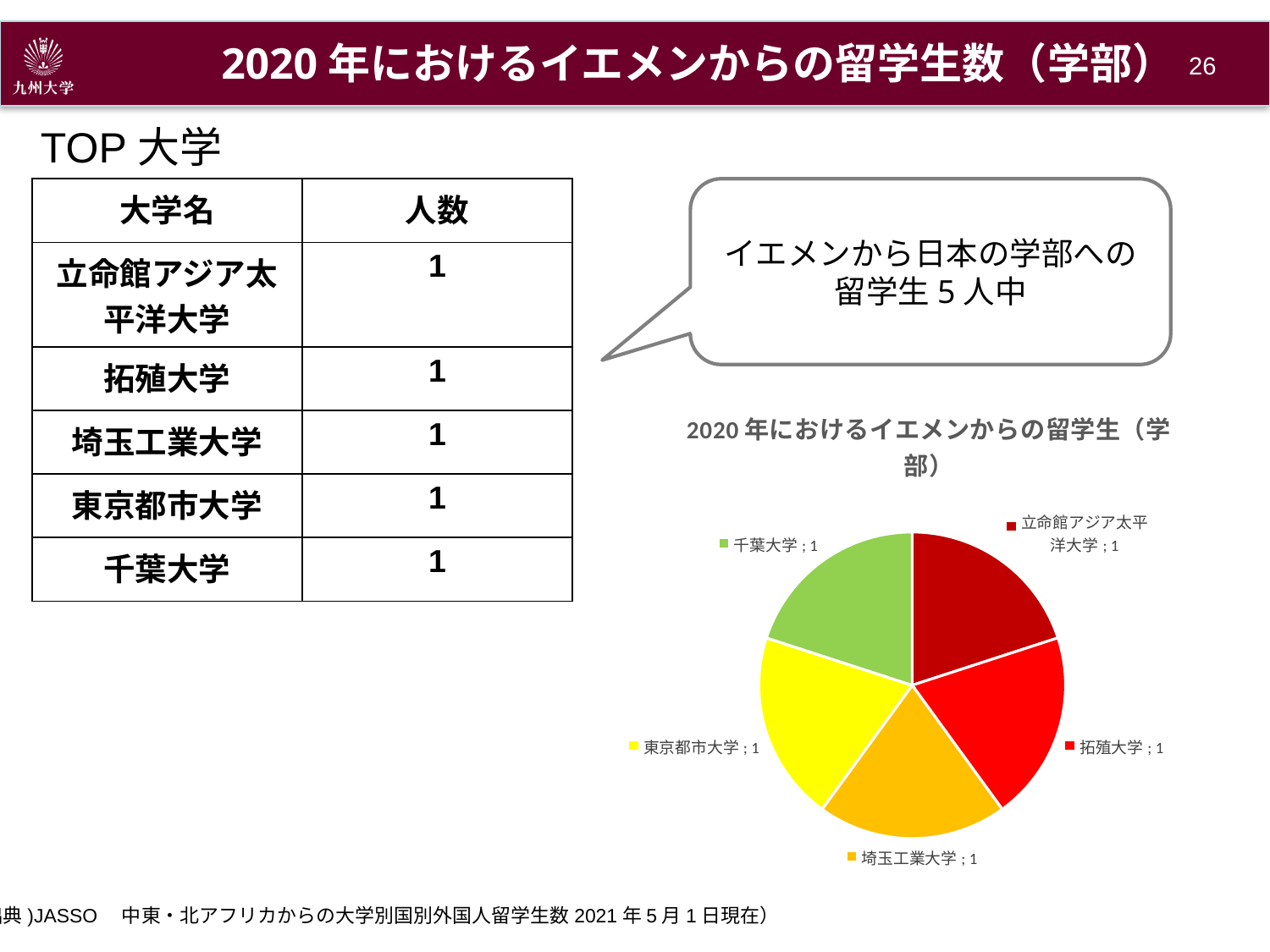
What is the value shown for 千葉大学 in the pie chart? 1 Which slice of the pie chart is coloured green? 千葉大学 What is the total of all the slices in the pie chart? 5 What is the title of the pie chart? 2020年におけるイエメンからの留学生（学部） What is the difference between the values for 千葉大学 and 東京都市大学 in the pie chart? 0 What is the value shown for 拓殖大学 in the pie chart? 1 What share of the pie does the 拓殖大学 slice represent? 20% What is the value shown for 立命館アジア太平洋大学 in the pie chart? 1 How many slices does the pie chart have? 5 What is the value shown for 埼玉工業大学 in the pie chart? 1 What is the value shown for 東京都市大学 in the pie chart? 1 What kind of chart is shown on the slide? pie chart